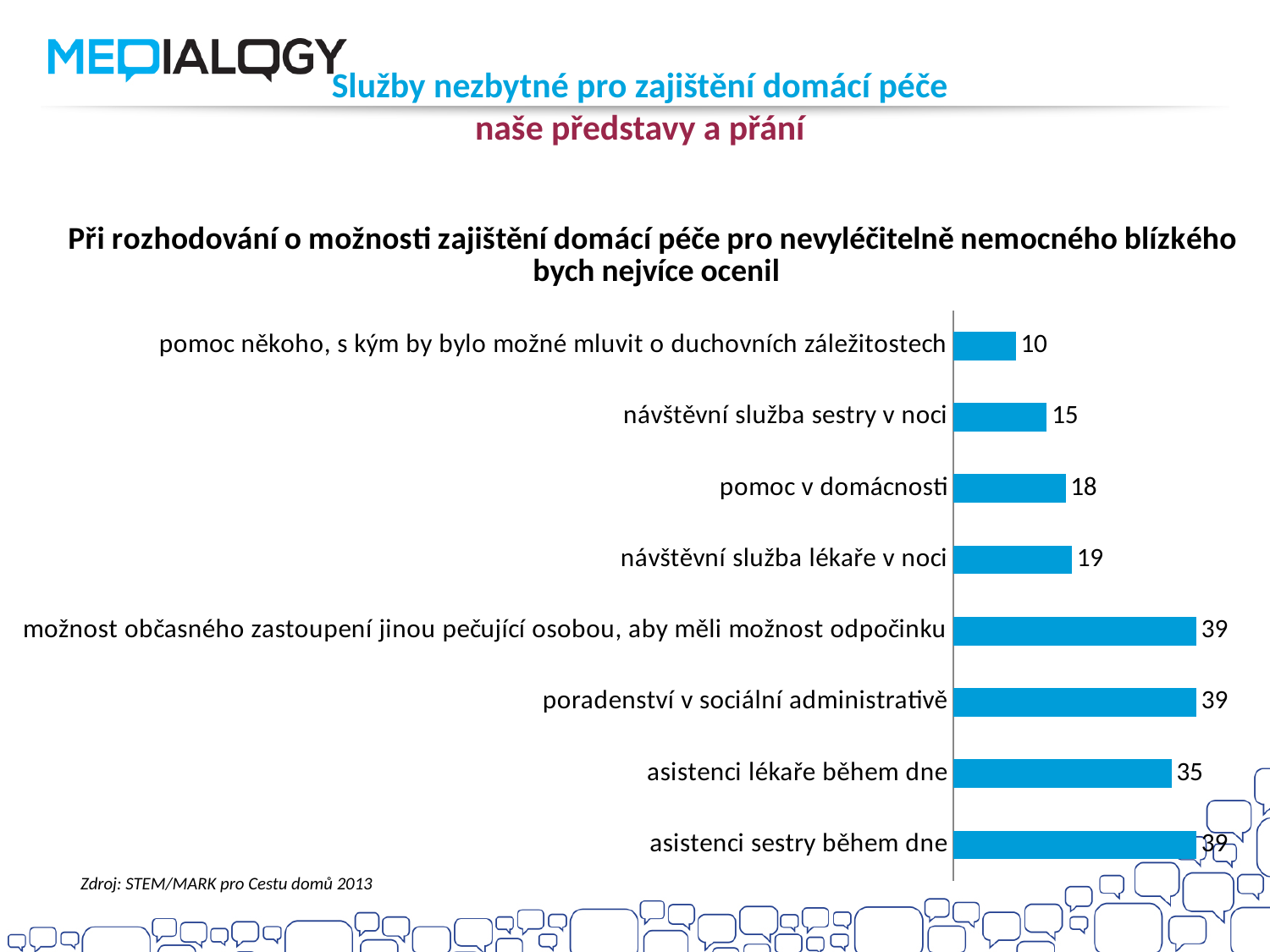
What is the value for "poradenství v sociální administrativě"? 39 What is the value for "možnost občasného zastoupení jinou pečující osobou, aby měli možnost odpočinku"? 39 Which has a larger value: "návštěvní služba lékaře v noci" or "pomoc v domácnosti"? návštěvní služba lékaře v noci What is the value for "návštěvní služba sestry v noci"? 15 Which category has the lowest value? pomoc někoho, s kým by bylo možné mluvit o duchovních záležitostech What is the difference between the values for "poradenství v sociální administrativě" and "asistenci lékaře během dne"? 4 What is the value for "pomoc v domácnosti"? 18 What is the difference between the values for "možnost občasného zastoupení jinou pečující osobou, aby měli možnost odpočinku" and "pomoc někoho, s kým by bylo možné mluvit o duchovních záležitostech"? 29 What kind of chart is shown on the slide? bar chart What is the difference between the values for "návštěvní služba lékaře v noci" and "návštěvní služba sestry v noci"? 4 How many categories are shown in the chart? 8 What is the value for "asistenci lékaře během dne"? 35